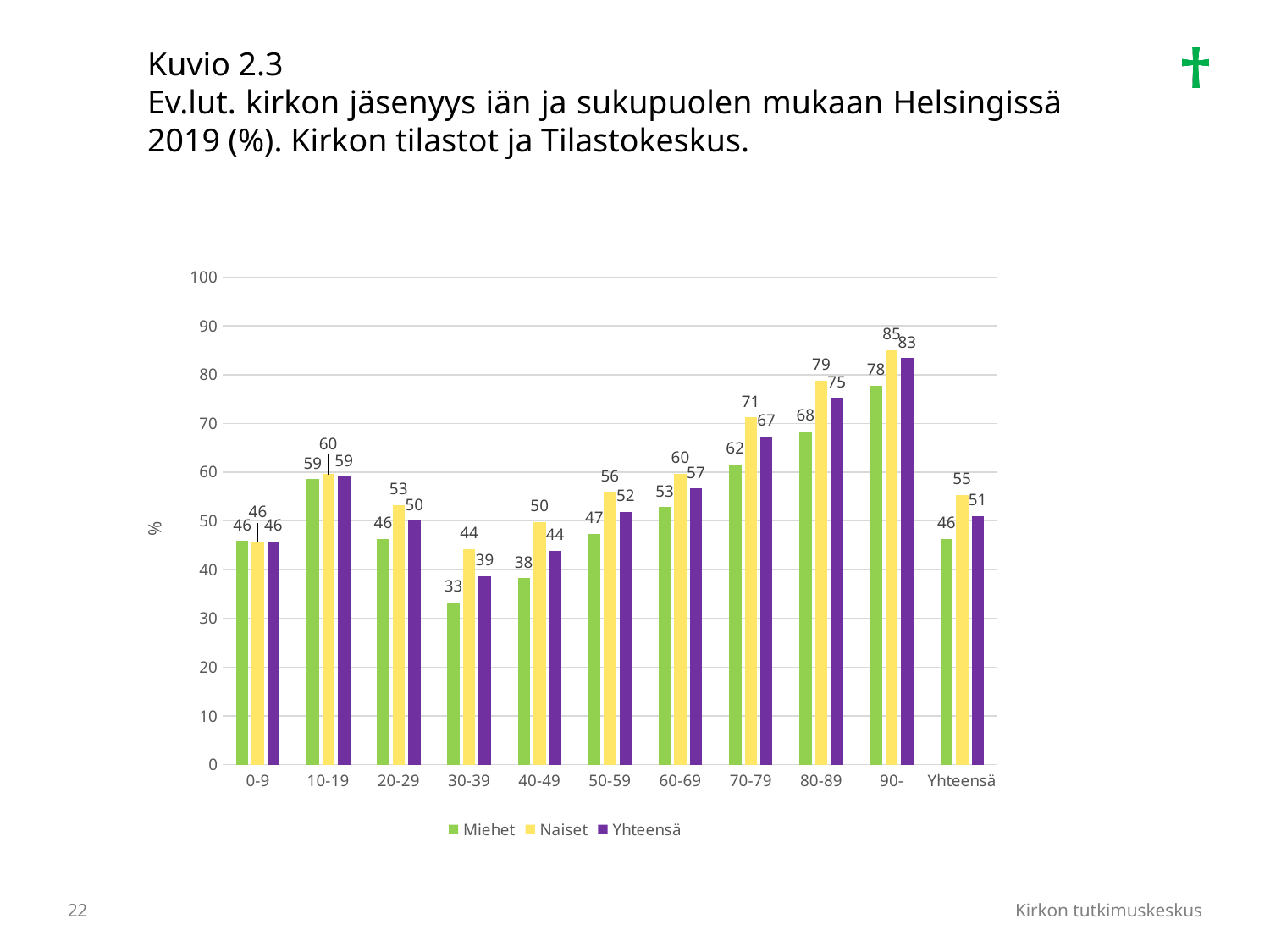
What kind of chart is shown on the slide? Bar chart What is the Yhteensä value for the 90- age group? 83 What is the difference between the Naiset and Miehet values in the 80-89 age group? 11 Which age group has the lowest value for Miehet? 30-39 What is the value for Miehet in the 70-79 age group? 62 Which is larger in the 40-49 age group, the value for Miehet or for Naiset? Naiset Which age group has the highest value for Naiset? 90- What is the value for Naiset in the 30-39 age group? 44 How many categories are shown on the x axis? 11 How many series does the legend list? 3 What is the label of the y axis? % Do the Yhteensä values rise or fall from the 40-49 age group to the 90- age group? Rise